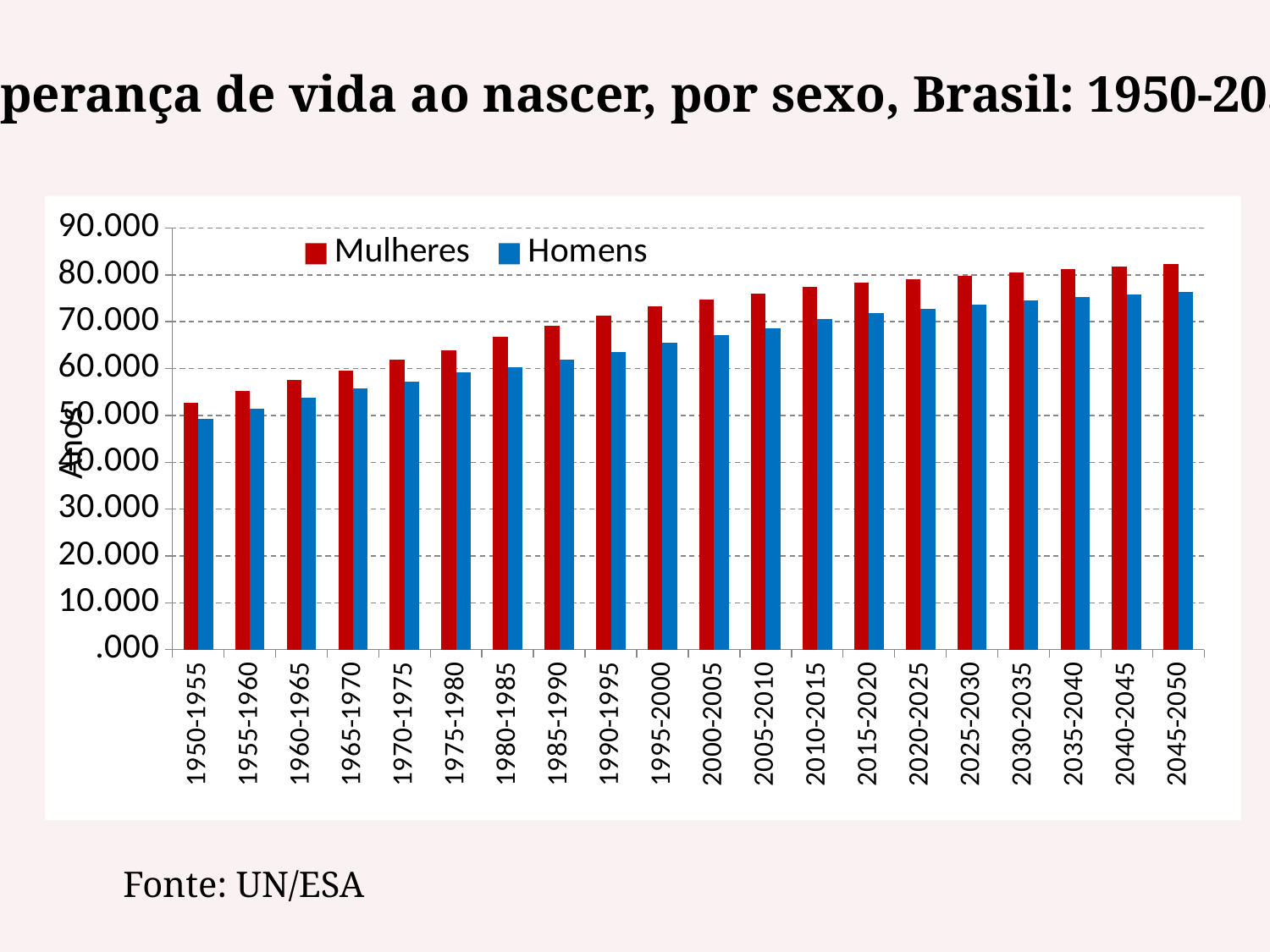
Which period has the highest value for Mulheres? 2045-2050 How many series does the legend list? 2 Do the values for Homens rise or fall across the periods on the x axis? rise In 1950-1955, which series has the larger value, Mulheres or Homens? Mulheres How many five-year periods are shown on the x axis? 20 Is the value for Mulheres in 1950-1955 greater or less than 60.000? less Which colour represents the Homens series in the chart? blue Which period has the lowest value for Homens? 1950-1955 In 2045-2050, which series has the larger value, Mulheres or Homens? Mulheres Do the values for Mulheres rise or fall from 1950-1955 to 2045-2050? rise Is the value for Homens in 2045-2050 greater or less than 70.000? greater What kind of chart is shown on the slide? bar chart